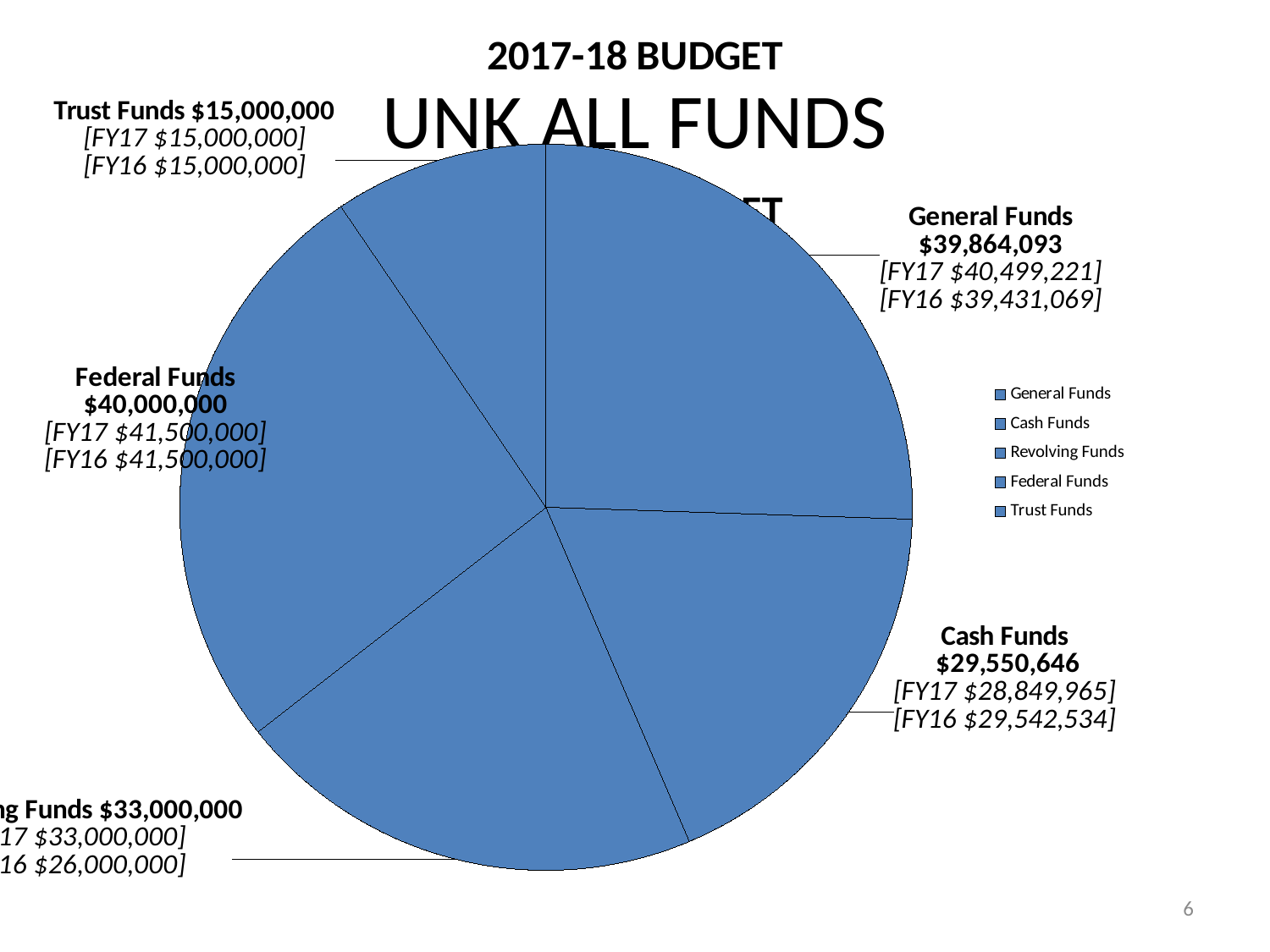
What kind of chart is shown on the slide? Pie chart What is the value for Cash Funds in the pie chart? $29,550,646 How many slices does the pie chart have? 5 What is the value for General Funds in the pie chart? $39,864,093 What is the title of the chart on the slide? 2017-18 BUDGET What is the value for Trust Funds in the pie chart? $15,000,000 What is the value for Federal Funds in the pie chart? $40,000,000 What FY16 value is shown for Cash Funds? $29,542,534 What is the difference between General Funds and Cash Funds? $10,313,447 What FY17 value is shown for General Funds? $40,499,221 Which is larger, Federal Funds or General Funds? Federal Funds Which fund category has the smallest slice in the pie chart? Trust Funds